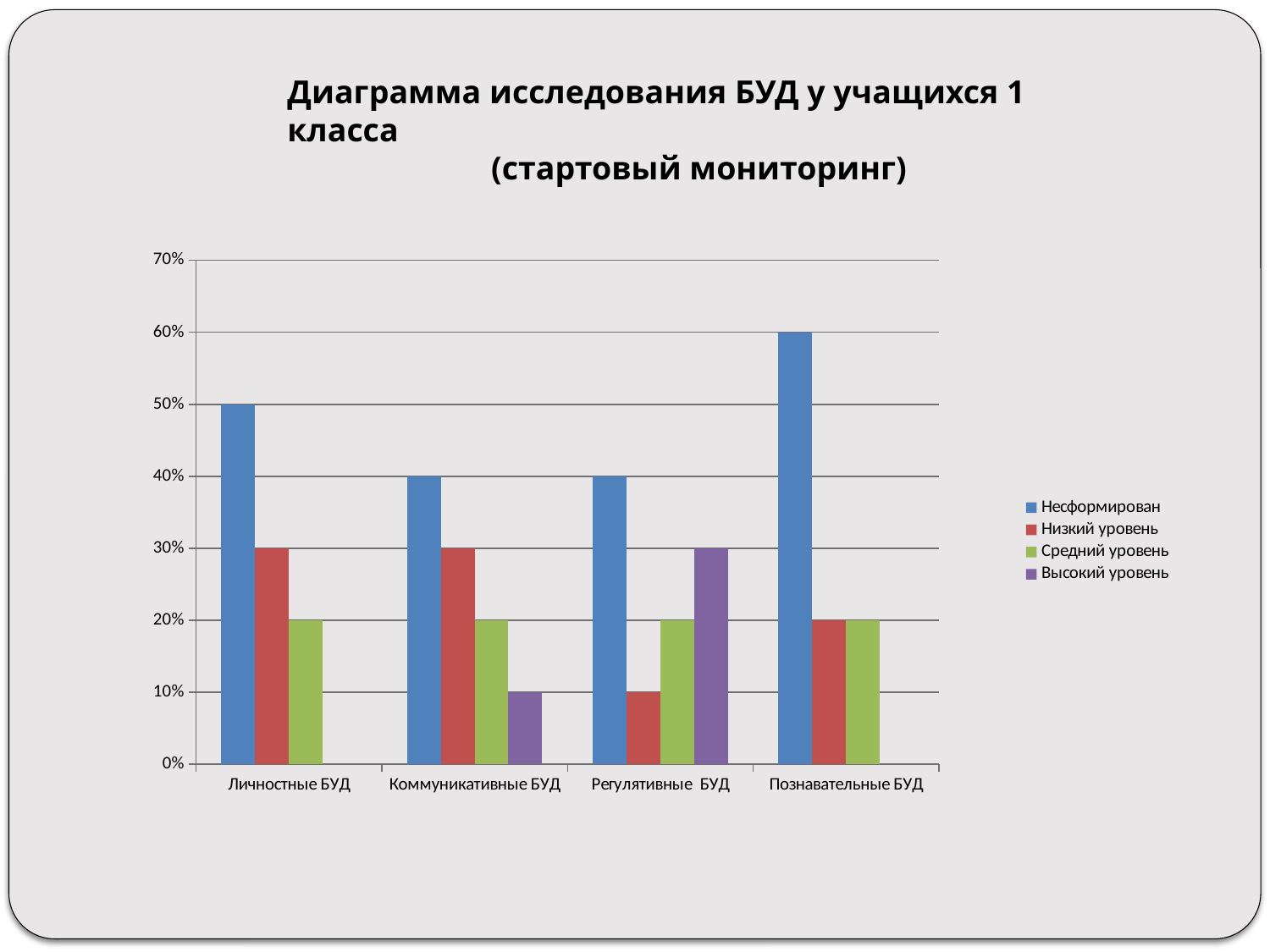
How many series does the legend list? 4 What is the value of Низкий уровень for Регулятивные БУД? 10% Which series is shown in purple in the legend? Высокий уровень How many categories are shown on the x axis? 4 For which category is the Низкий уровень value lowest? Регулятивные БУД What is the value of Высокий уровень for Регулятивные БУД? 30% What is the difference between the Несформирован values for Познавательные БУД and Коммуникативные БУД? 20% Which is larger: Высокий уровень for Регулятивные БУД or Высокий уровень for Коммуникативные БУД? Регулятивные БУД For which category is the Несформирован value highest? Познавательные БУД What kind of chart is shown on the slide? bar chart What is the value of Несформирован for Личностные БУД? 50% What is the value of Несформирован for Познавательные БУД? 60%